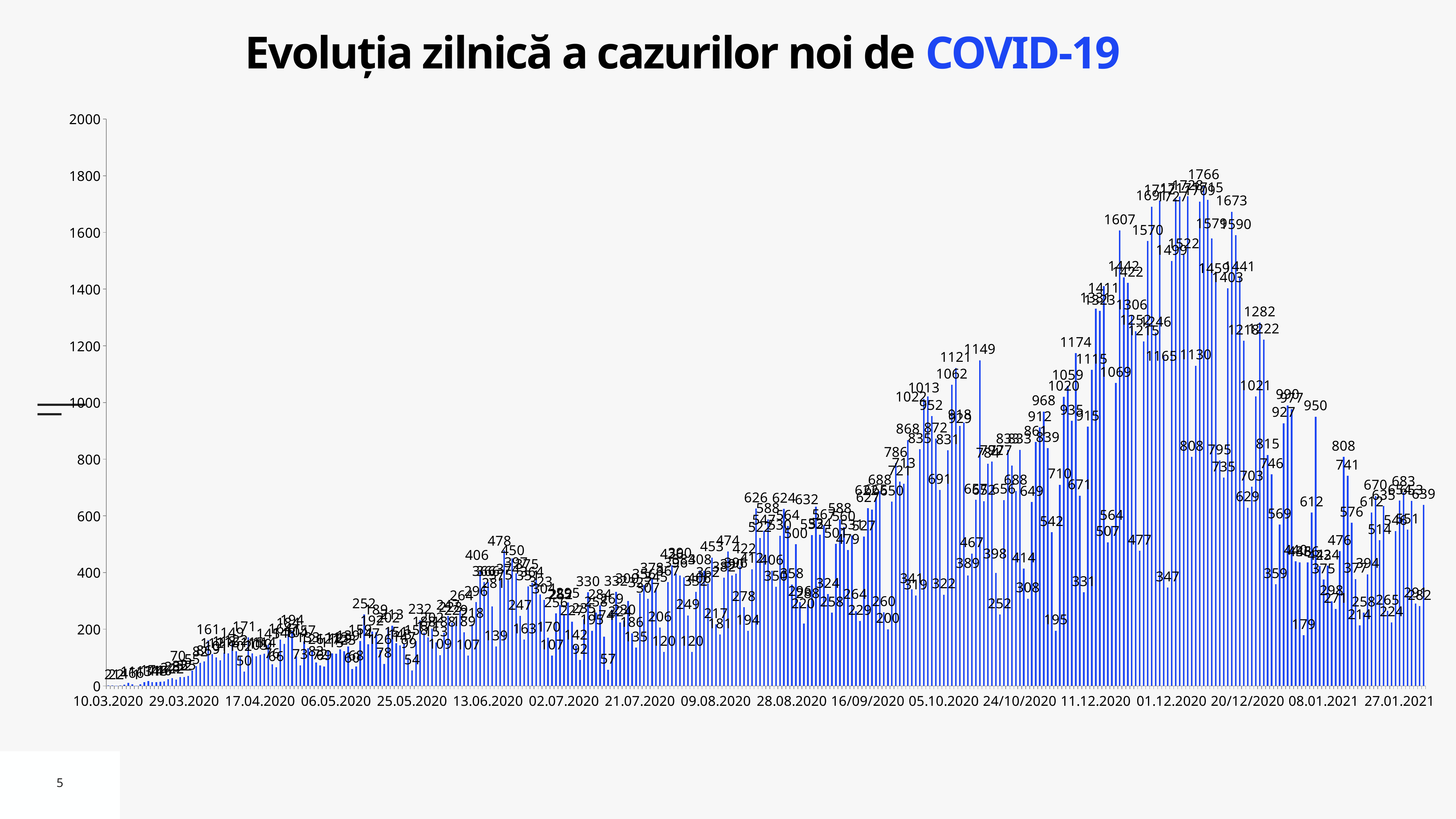
Do the daily values generally rise or fall from 10.03.2020 to 01.12.2020? rise What is the last date label on the horizontal axis? 27.01.2021 How many date labels are shown on the horizontal axis? 18 What is the title of the chart? Evoluția zilnică a cazurilor noi de COVID-19 Is the highest bar on the chart greater or less than 1800? less What kind of chart is shown on the slide? bar chart What is the first date label on the horizontal axis? 10.03.2020 Which is higher: the peak of daily cases in June 2020 (labeled 478) or the peak in December 2020 (labeled 1766)? December 2020 What is the difference between the overall peak value of 1766 and the June 2020 peak value of 478? 1288 Is the highest bar on the chart greater or less than 1600? greater What is the maximum value shown on the vertical axis? 2000 What is the highest daily value labeled on the chart? 1766